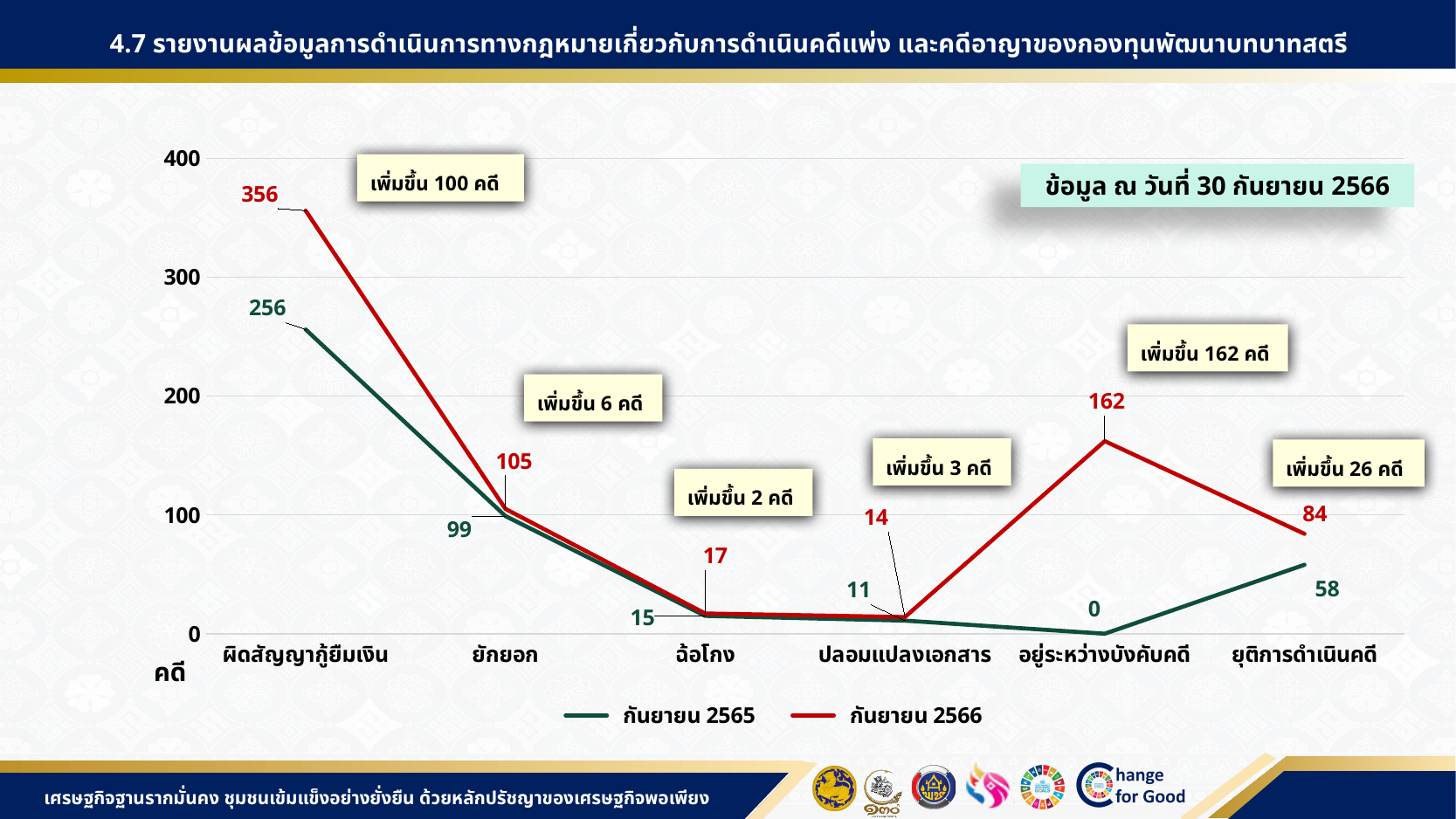
How many categories are shown on the x axis? 6 What is the value for ยักยอก in the กันยายน 2565 series? 99 What date is the data stated to be as of, according to the box on the chart? 30 กันยายน 2566 How many series does the legend list? 2 Which is larger for ปลอมแปลงเอกสาร: the กันยายน 2565 value or the กันยายน 2566 value? กันยายน 2566 Which category has the highest value in the กันยายน 2566 series? ผิดสัญญากู้ยืมเงิน What is the value for ผิดสัญญากู้ยืมเงิน in the กันยายน 2566 series? 356 What is the difference between the กันยายน 2566 and กันยายน 2565 values for ผิดสัญญากู้ยืมเงิน? 100 What is the value for ยุติการดำเนินคดี in the กันยายน 2566 series? 84 Which category has the lowest value in the กันยายน 2565 series? อยู่ระหว่างบังคับคดี What type of chart is shown on the slide? line chart What is the value for อยู่ระหว่างบังคับคดี in the กันยายน 2565 series? 0